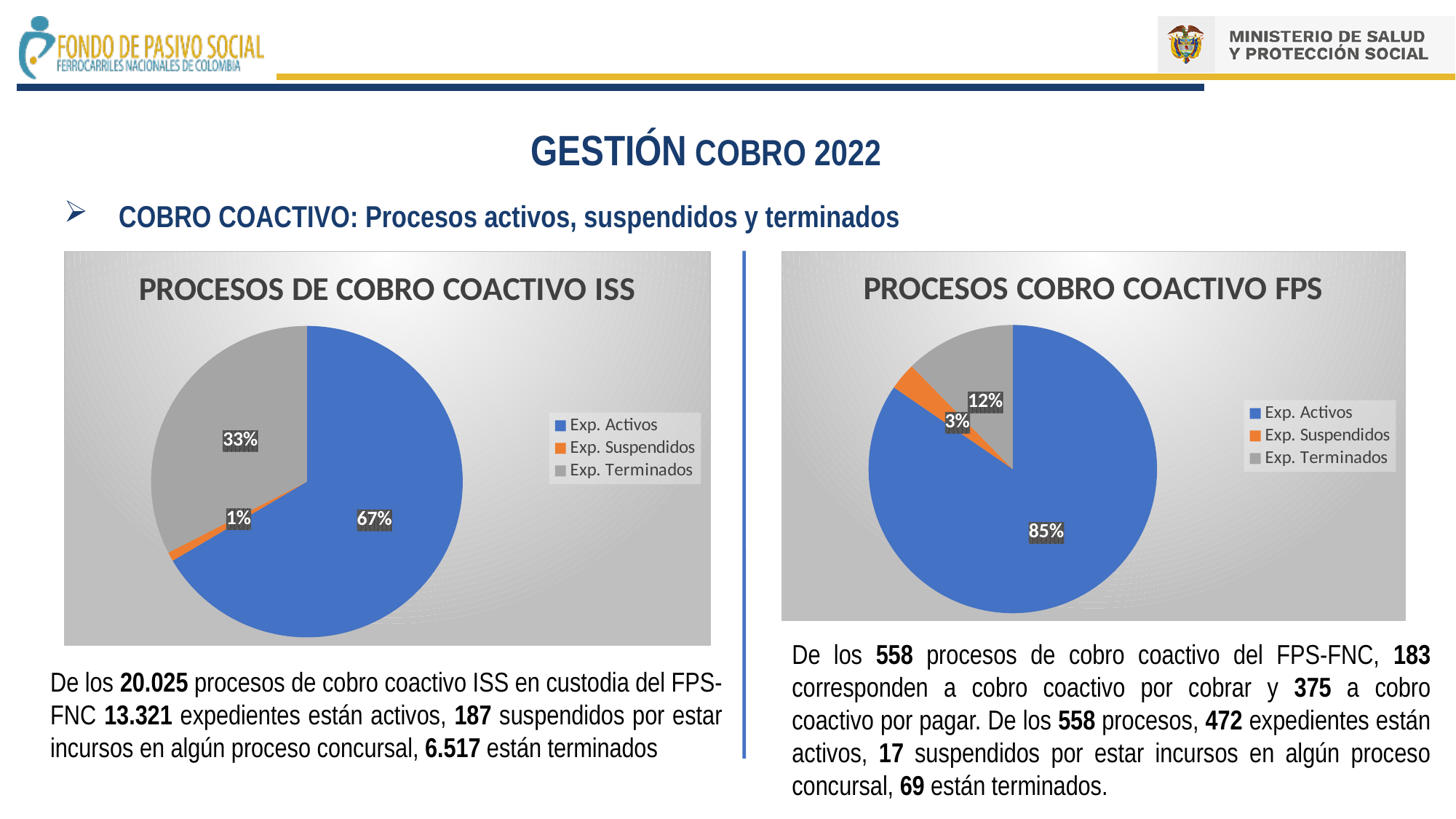
In the 'PROCESOS DE COBRO COACTIVO ISS' chart, what share of the pie is Exp. Suspendidos? 1% What type of chart is 'PROCESOS COBRO COACTIVO FPS'? Pie chart In the 'PROCESOS COBRO COACTIVO FPS' chart, what share of the pie is Exp. Suspendidos? 3% In the 'PROCESOS DE COBRO COACTIVO ISS' chart, which category has the largest slice? Exp. Activos Which chart has the larger share for Exp. Activos, 'PROCESOS DE COBRO COACTIVO ISS' or 'PROCESOS COBRO COACTIVO FPS'? PROCESOS COBRO COACTIVO FPS In the 'PROCESOS DE COBRO COACTIVO ISS' chart, what share of the pie is Exp. Terminados? 33% How many categories does the legend of the 'PROCESOS DE COBRO COACTIVO ISS' chart list? 3 In the 'PROCESOS COBRO COACTIVO FPS' chart, which category has the smallest slice? Exp. Suspendidos In the 'PROCESOS DE COBRO COACTIVO ISS' chart, what is the difference in percentage points between Exp. Activos and Exp. Terminados? 34 percentage points